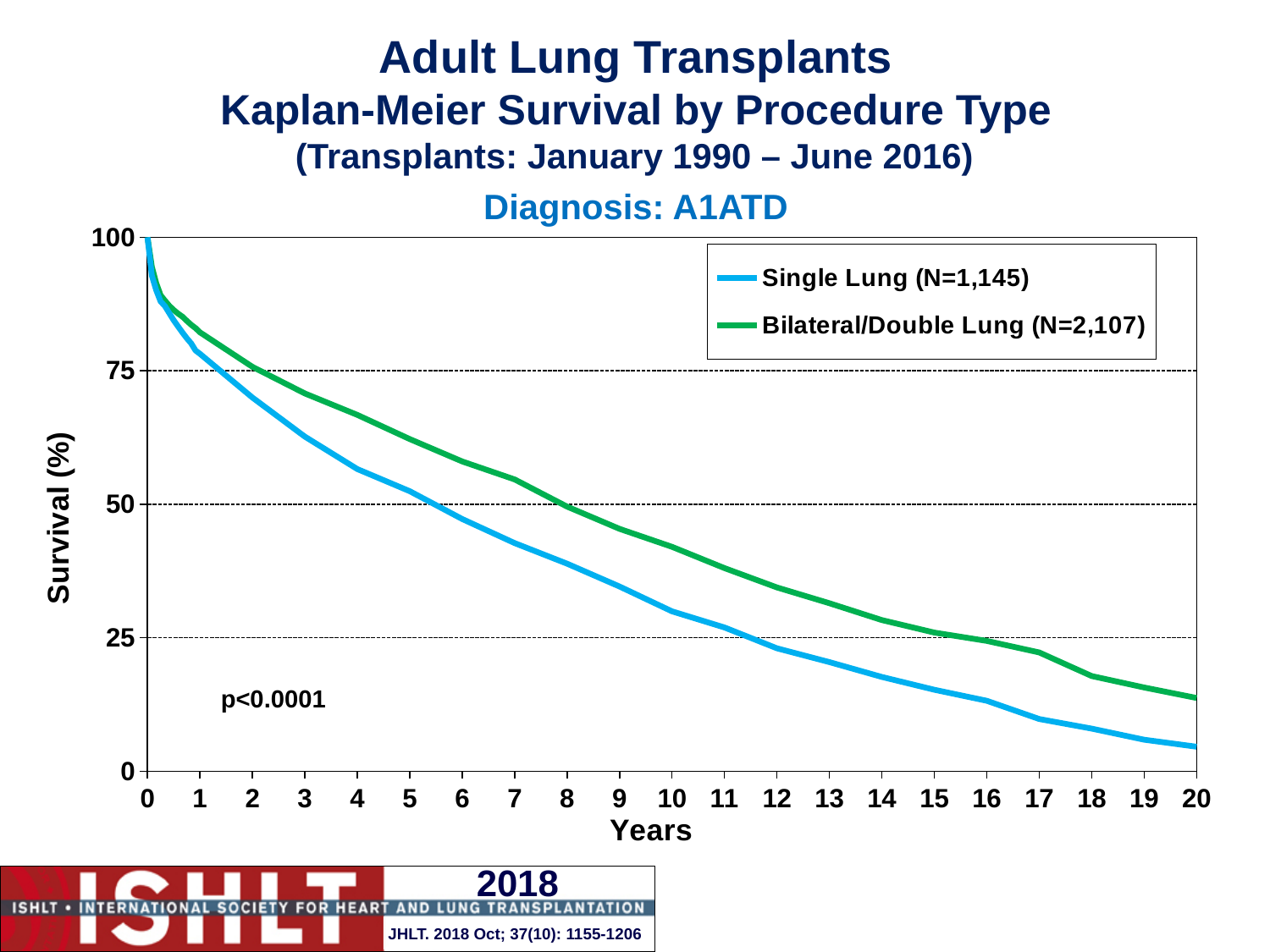
Which series has the higher survival at 20 years? Bilateral/Double Lung Is the survival for Bilateral/Double Lung at 5 years greater or less than 50? greater What p-value is printed on the chart? p<0.0001 What kind of chart is shown on the slide? line chart What is the N shown in the legend for Single Lung? N=1,145 How many series does the legend list? 2 Is the survival for Bilateral/Double Lung at 10 years greater or less than 50? less Is the survival for Single Lung at 20 years greater or less than 25? less Which series has the lower survival at 15 years? Single Lung Do the survival curves rise or fall as years increase? fall Which series has the higher survival at 10 years, Single Lung or Bilateral/Double Lung? Bilateral/Double Lung